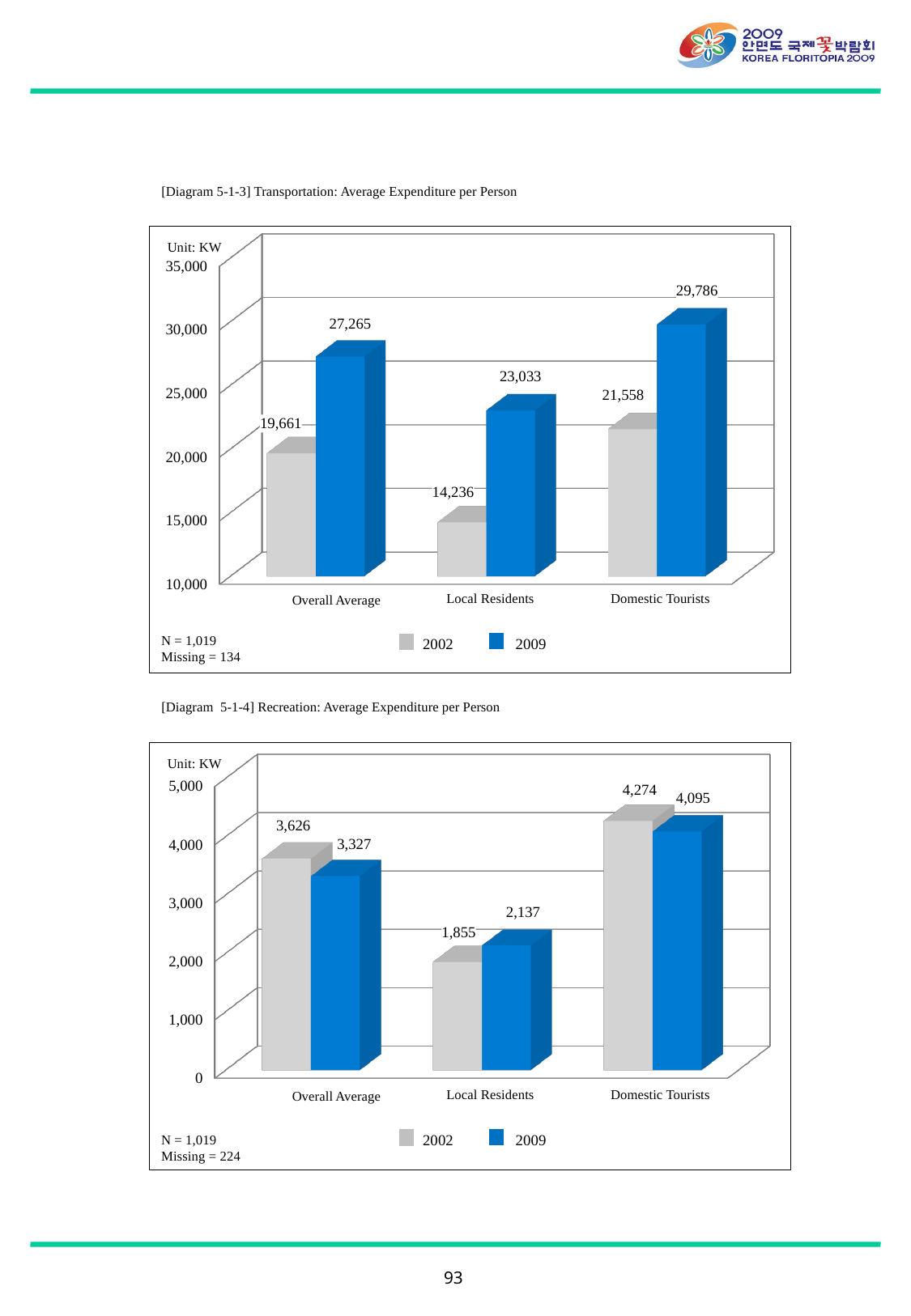
In the Recreation chart, what is the difference between the 2009 and 2002 values for Local Residents? 282 In the Recreation chart, how many categories are shown on the x axis? 3 In the Transportation chart, what is the 2009 average expenditure per person for Domestic Tourists? 29,786 In the Recreation chart, what is the 2002 value for Domestic Tourists? 4,274 In the Transportation chart, what is the difference between the 2009 and 2002 values for Overall Average? 7,604 What kind of chart is the Recreation chart? Bar chart In the Transportation chart, which category has the lowest 2002 value? Local Residents In the Transportation chart, what is the 2002 value for Local Residents? 14,236 In the Recreation chart, which is larger for Overall Average, the 2002 value or the 2009 value? 2002 In the Transportation chart, how many series does the legend list? 2 In the Recreation chart, what is the 2009 value for Local Residents? 2,137 In the Transportation chart, which category has the highest 2009 value? Domestic Tourists